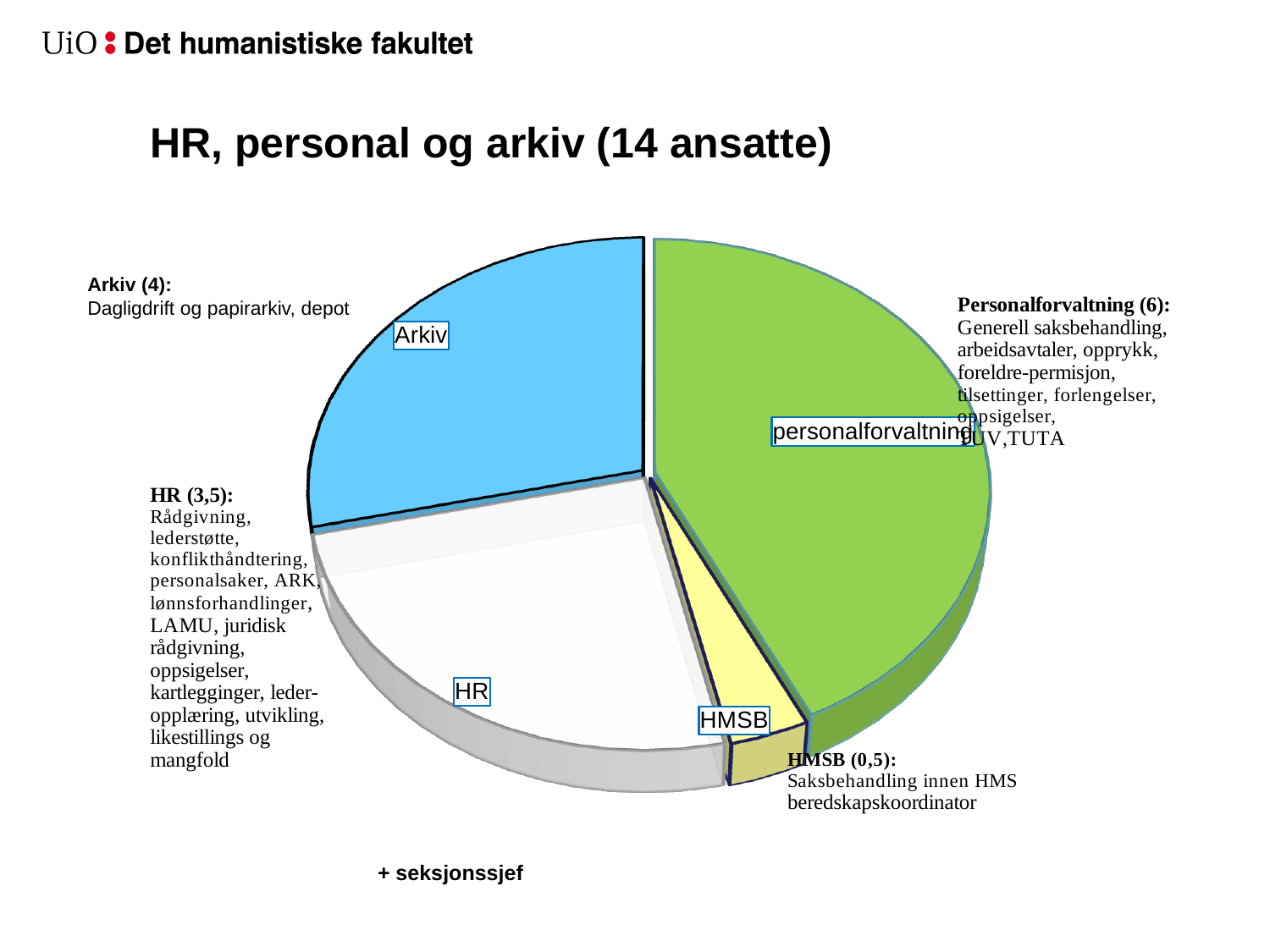
Which slice is larger, Arkiv or HMSB? Arkiv What is the difference between the number of employees in Personalforvaltning and in Arkiv? 2 What is the title of the slide containing the pie chart? HR, personal og arkiv (14 ansatte) Which slice of the pie chart is the smallest? HMSB Which slice of the pie chart is the largest? personalforvaltning According to the annotation on the slide, how many employees are in HMSB? 0,5 According to the annotation on the slide, how many employees are in Personalforvaltning? 6 How many slices does the pie chart have? 4 What kind of chart is shown on the slide? pie chart According to the annotation on the slide, how many employees are in HR? 3,5 According to the annotation on the slide, how many employees are in Arkiv? 4 What colour is the personalforvaltning slice of the pie chart? green